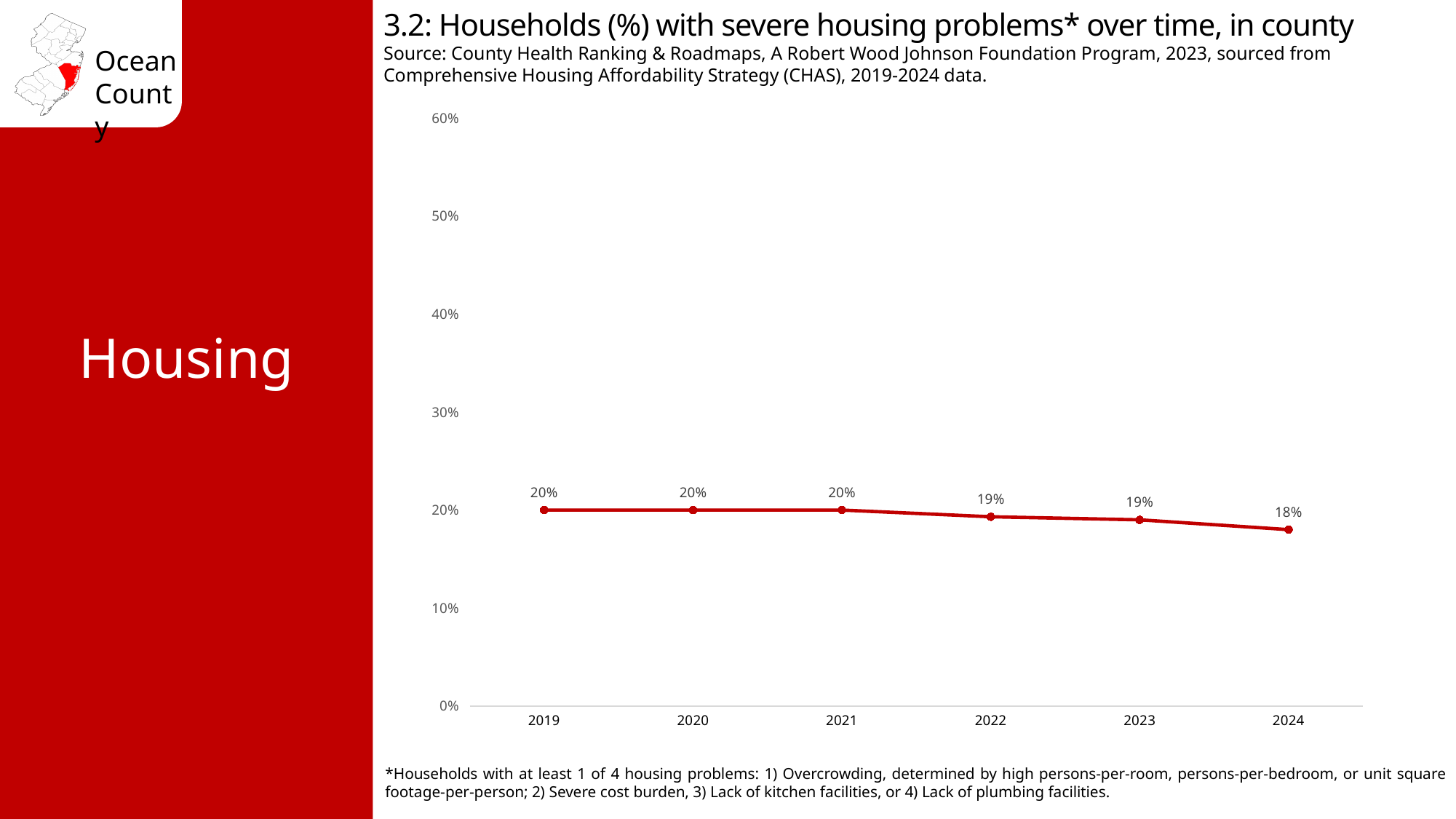
Is the value for 2023 greater or less than 30%? less How many years are plotted on the chart? 6 What is the difference between the 2019 value and the 2024 value? 2% What is the title of the chart? 3.2: Households (%) with severe housing problems* over time, in county Which year has the lowest percentage of households with severe housing problems? 2024 Which is larger, the value for 2021 or the value for 2024? 2021 What is the highest value shown on the vertical axis? 60% What kind of chart is shown on the slide? line chart What percentage of households had severe housing problems in 2024? 18% What percentage of households had severe housing problems in 2019? 20% What percentage of households had severe housing problems in 2022? 19% Do the values rise or fall from 2019 to 2024? fall